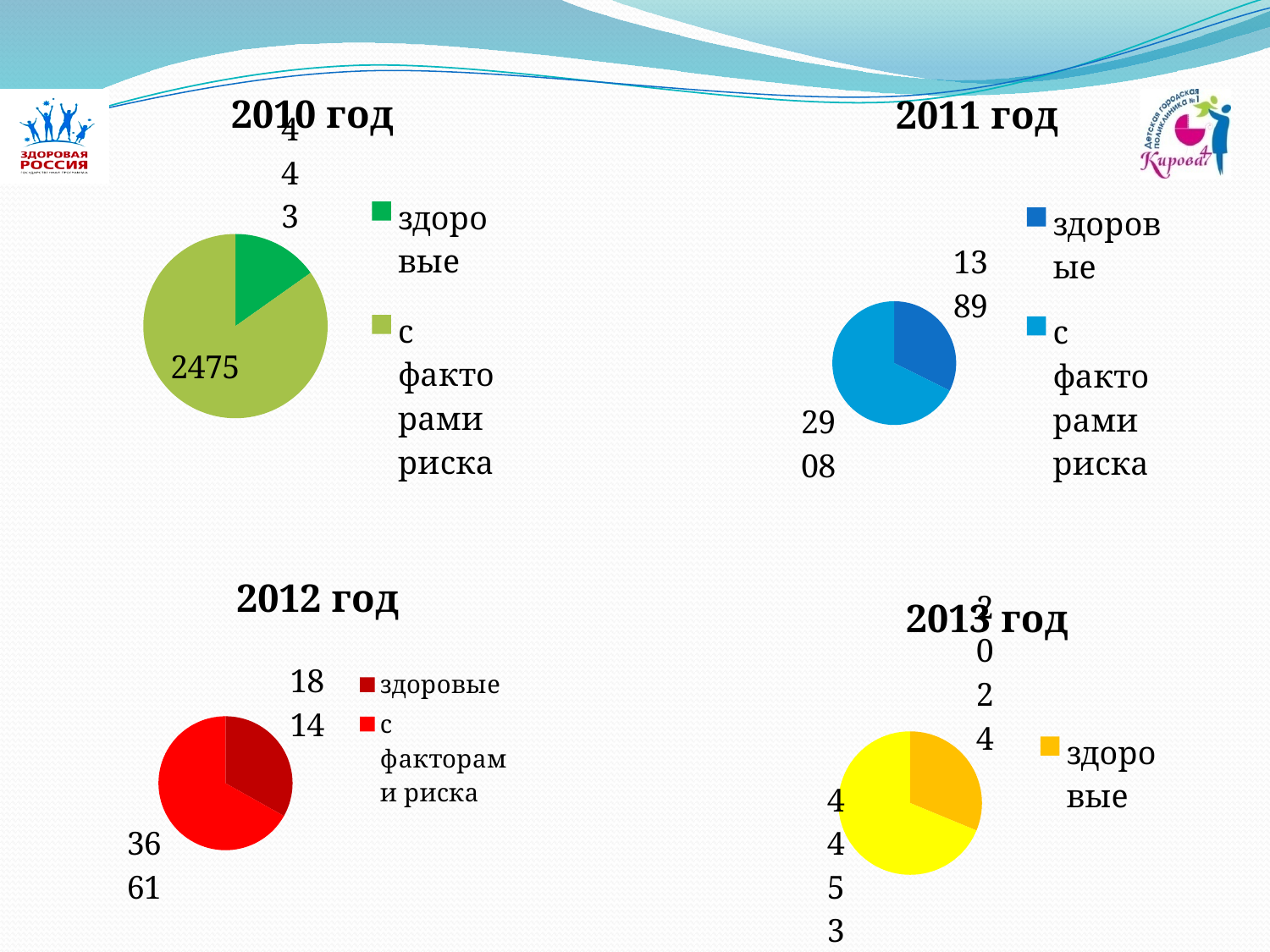
In the 2012 год chart, what is the value for с факторами риска? 3661 In the 2010 год chart, which category has the smaller slice? здоровые In the 2012 год chart, what is the value for здоровые? 1814 What type of chart is the 2013 год chart? pie chart In the 2010 год chart, what is the value for с факторами риска? 2475 In the 2012 год chart, what is the difference between с факторами риска and здоровые? 1847 In the 2011 год chart, which category has the larger slice? с факторами риска How many series does the legend of the 2012 год chart list? 2 In the 2013 год chart, what is the value for здоровые? 2024 In the 2011 год chart, what is the value for с факторами риска? 2908 In the 2011 год chart, what is the value for здоровые? 1389 In the 2010 год chart, what is the value for здоровые? 443